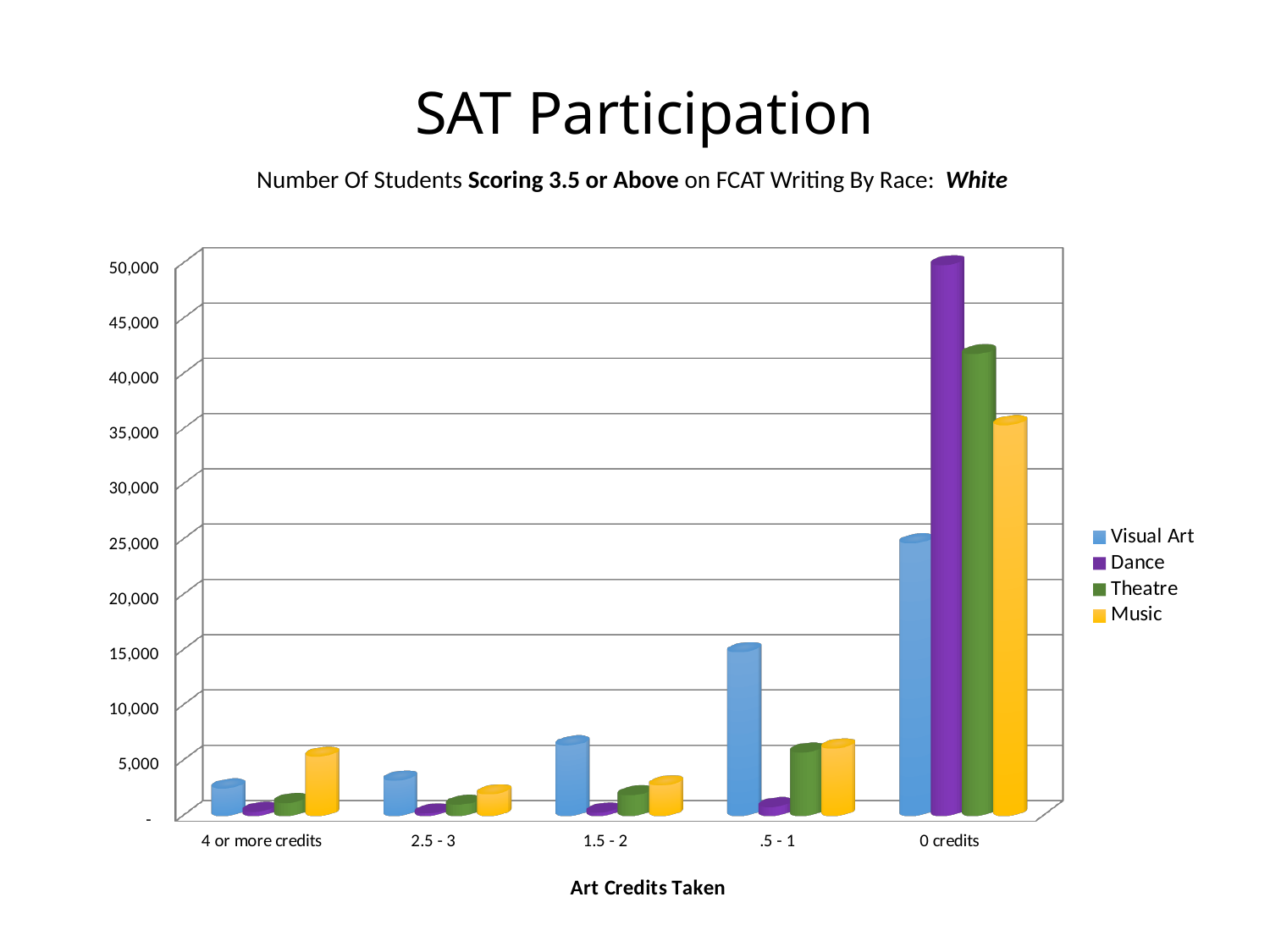
What is the title of the x axis? Art Credits Taken In the 0 credits category, which is larger: Theatre or Music? Theatre Which series has the lowest bar in the 0 credits category? Visual Art Do the Visual Art values rise or fall moving from 4 or more credits to 0 credits along the x axis? rise What kind of chart is shown on the slide? bar chart Which series has the highest bar in the .5 - 1 category? Visual Art Which series has the highest bar in the 0 credits category? Dance How many art-credit categories are shown on the x axis? 5 Which series has the highest bar in the 4 or more credits category? Music Is the value for Dance at 0 credits greater or less than 45,000? greater Is the value for Visual Art at .5 - 1 credits greater or less than 10,000? greater How many series does the legend list? 4